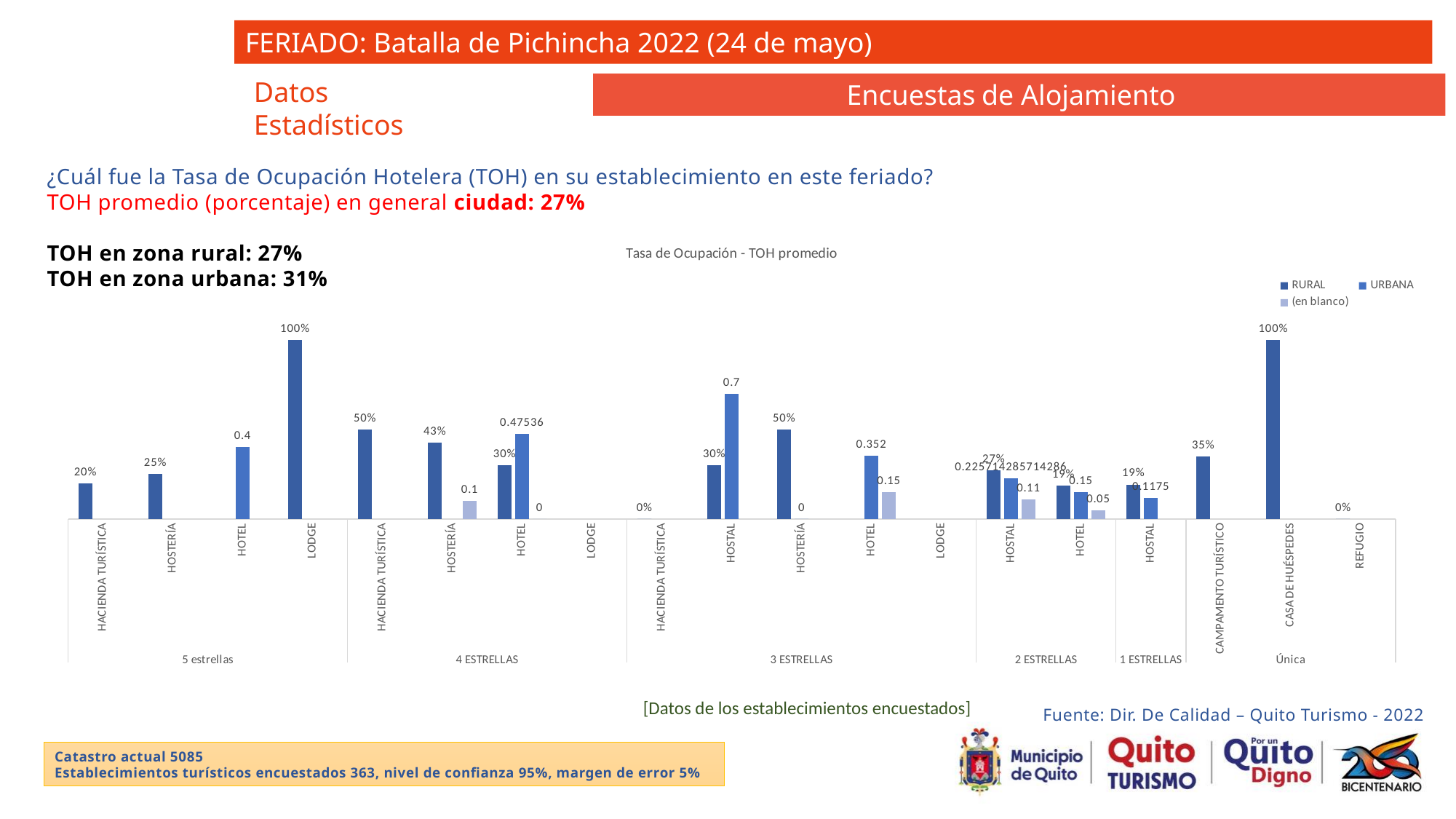
What is the URBANA value for HOTEL in the 4 ESTRELLAS group? 0.47536 What kind of chart is shown on the slide? Bar chart What is the title of the chart? Tasa de Ocupación - TOH promedio What is the URBANA value for HOTEL in the 3 ESTRELLAS group? 0.352 What is the (en blanco) value for HOTEL in the 2 ESTRELLAS group? 0.05 What is the RURAL value for CAMPAMENTO TURÍSTICO in the Única group? 35% How many series does the chart legend list? 3 What is the RURAL value for HACIENDA TURÍSTICA in the 5 estrellas group? 20% In the 5 estrellas group, what is the difference between the RURAL values for HOSTERÍA and HACIENDA TURÍSTICA? 5 percentage points What is the RURAL value for LODGE in the 5 estrellas group? 100% In the 4 ESTRELLAS group, which has the larger RURAL value: HACIENDA TURÍSTICA or HOSTERÍA? HACIENDA TURÍSTICA What is the URBANA value for HOSTAL in the 3 ESTRELLAS group? 0.7